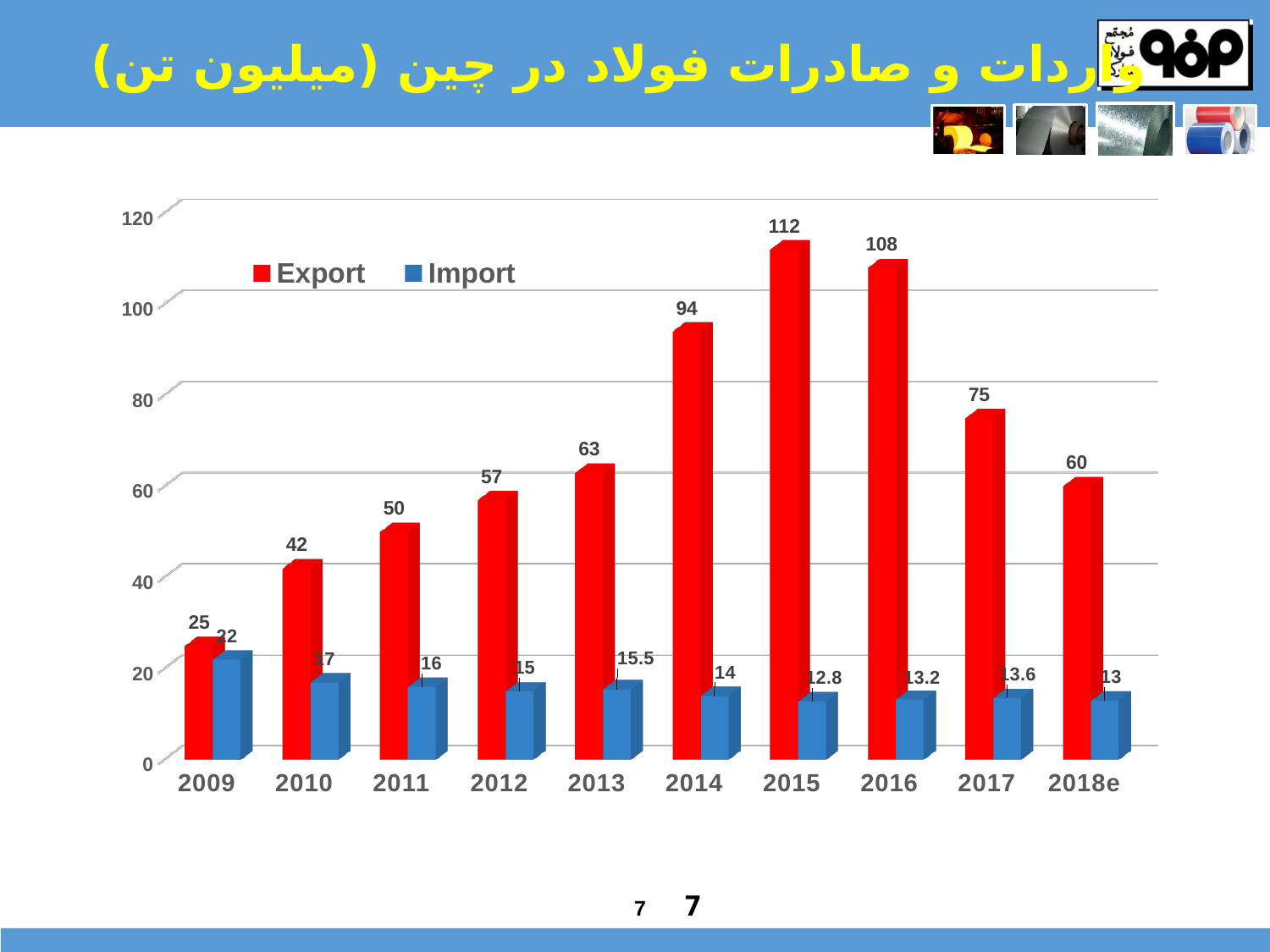
Which year has the highest Export value? 2015 Which year has the lowest Import value? 2015 How many years are shown on the x axis? 10 Is the Export value for 2014 greater or less than 80? greater What is the Import value for 2013? 15.5 Which is larger, the Export value for 2017 or the Export value for 2018e? 2017 How many series does the legend list? 2 What is the Export value for 2018e? 60 What is the difference between the Export values for 2015 and 2016? 4 What is the Export value for 2015? 112 Does the Export value rise or fall from 2009 to 2015? rise What kind of chart is shown on the slide? bar chart